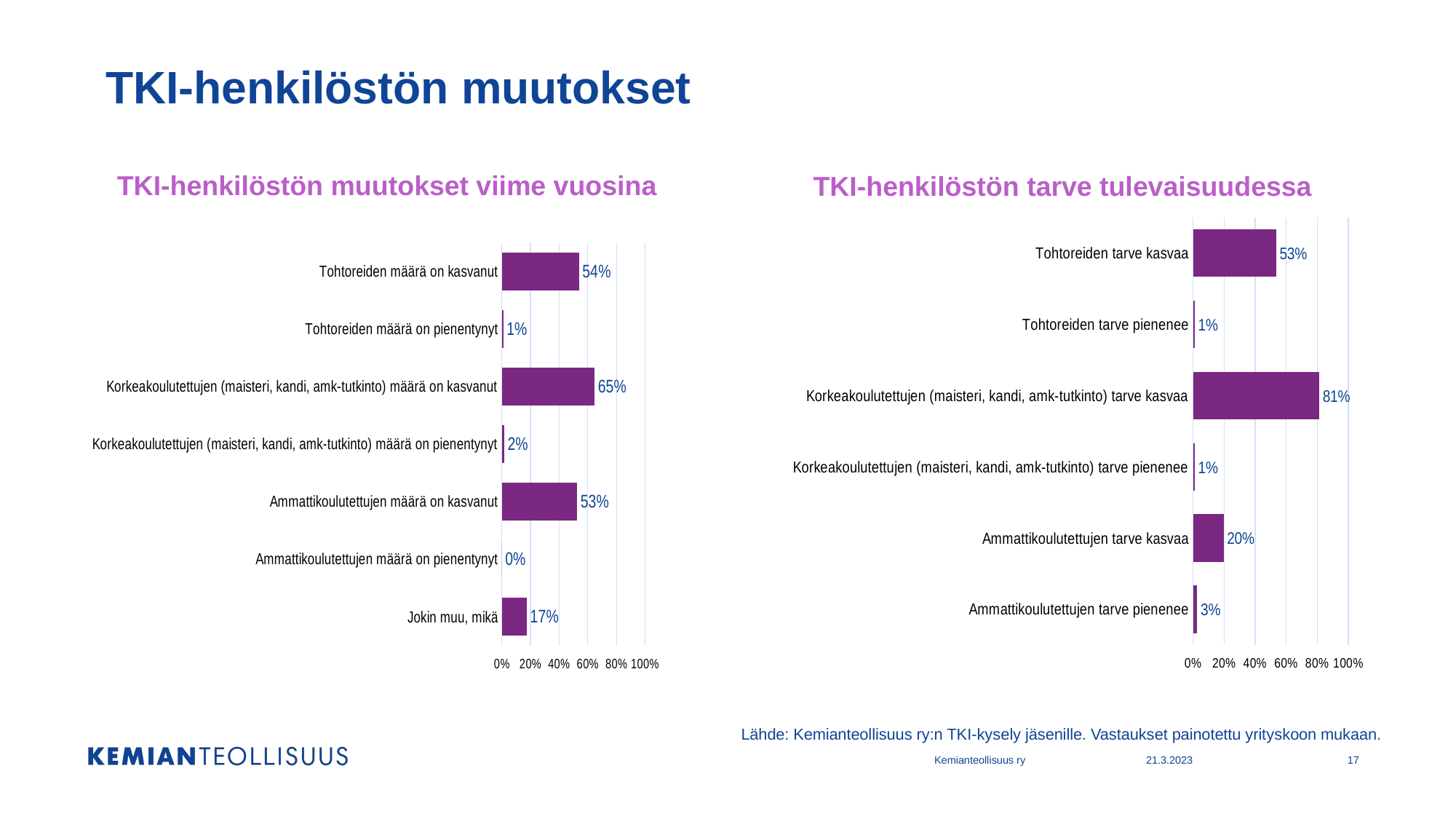
In the chart 'TKI-henkilöstön tarve tulevaisuudessa', what is the value for 'Korkeakoulutettujen (maisteri, kandi, amk-tutkinto) tarve kasvaa'? 81% In the chart 'TKI-henkilöstön muutokset viime vuosina', which category has the highest value? Korkeakoulutettujen (maisteri, kandi, amk-tutkinto) määrä on kasvanut In the chart 'TKI-henkilöstön muutokset viime vuosina', what is the value for 'Tohtoreiden määrä on kasvanut'? 54% In the chart 'TKI-henkilöstön muutokset viime vuosina', what is the value for 'Jokin muu, mikä'? 17% In the chart 'TKI-henkilöstön tarve tulevaisuudessa', which is larger: 'Tohtoreiden tarve kasvaa' or 'Ammattikoulutettujen tarve kasvaa'? Tohtoreiden tarve kasvaa In the chart 'TKI-henkilöstön tarve tulevaisuudessa', what is the value for 'Ammattikoulutettujen tarve kasvaa'? 20% In the chart 'TKI-henkilöstön muutokset viime vuosina', how many categories are shown? 7 In the chart 'TKI-henkilöstön muutokset viime vuosina', what is the difference between 'Korkeakoulutettujen (maisteri, kandi, amk-tutkinto) määrä on kasvanut' and 'Ammattikoulutettujen määrä on kasvanut'? 12% In the chart 'TKI-henkilöstön tarve tulevaisuudessa', what is the difference between 'Tohtoreiden tarve kasvaa' and 'Ammattikoulutettujen tarve pienenee'? 50% In the chart 'TKI-henkilöstön muutokset viime vuosina', which category has the lowest value? Ammattikoulutettujen määrä on pienentynyt What type of chart is 'TKI-henkilöstön tarve tulevaisuudessa'? Bar chart In the chart 'TKI-henkilöstön tarve tulevaisuudessa', how many categories are shown? 6